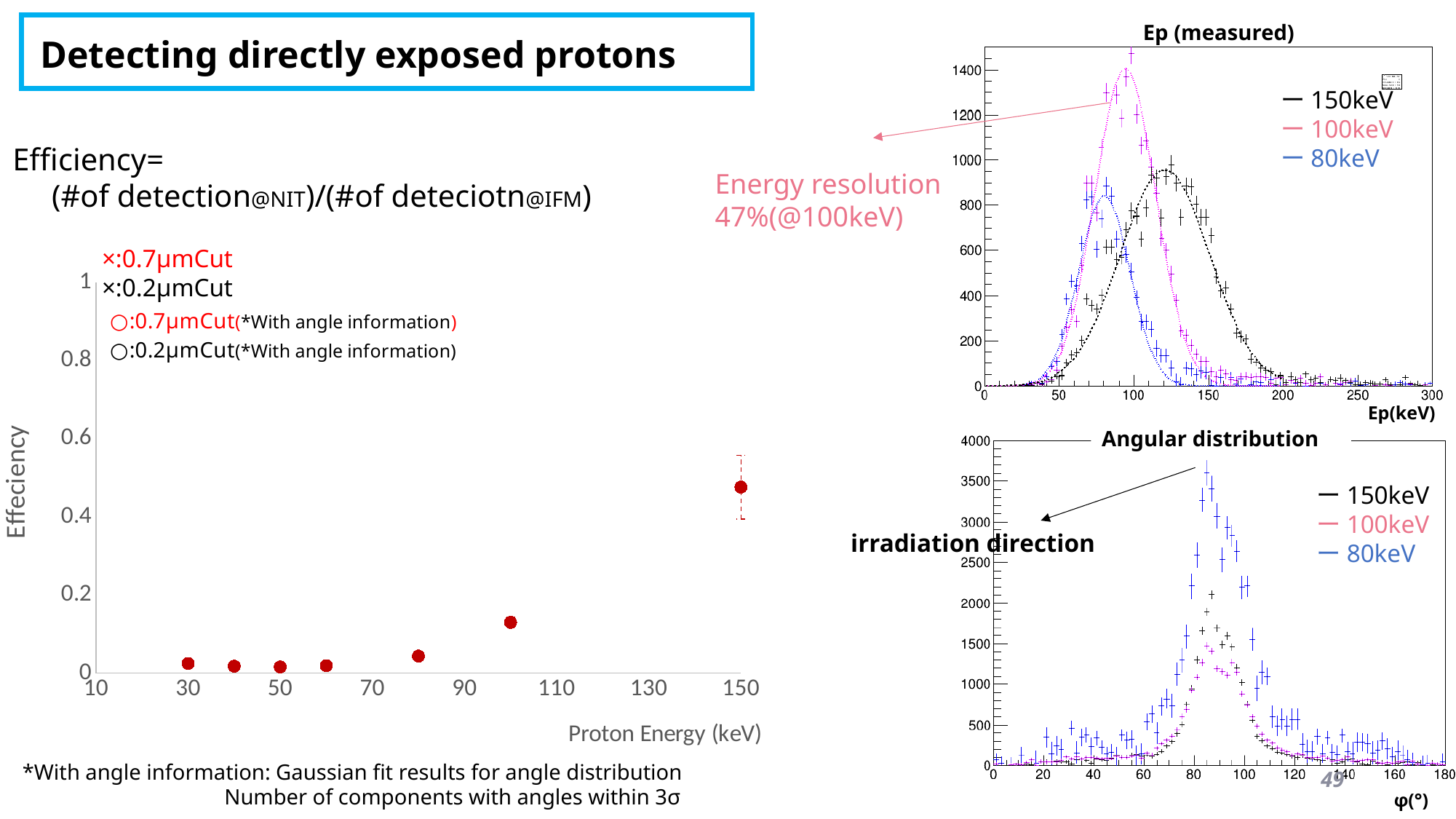
On the Efficiency chart (left), at which proton energy is the efficiency highest? 150 keV On the Efficiency chart (left), does the efficiency generally rise or fall as proton energy increases? rise On the Efficiency chart (left), what is the x-axis label? Proton Energy (keV) On the Ep (measured) chart, is the peak of the 100keV series greater or less than 1200? greater On the Angular distribution chart, which series has the highest peak? 80keV On the Efficiency chart (left), is the efficiency at 100 keV greater or less than 0.2? less On the Efficiency chart (left), is the efficiency at 150 keV greater or less than 0.4? greater On the Efficiency chart (left), how many data points are plotted? 7 On the Ep (measured) chart, how many series does the legend list? 3 On the Ep (measured) chart, which series has the highest peak? 100keV